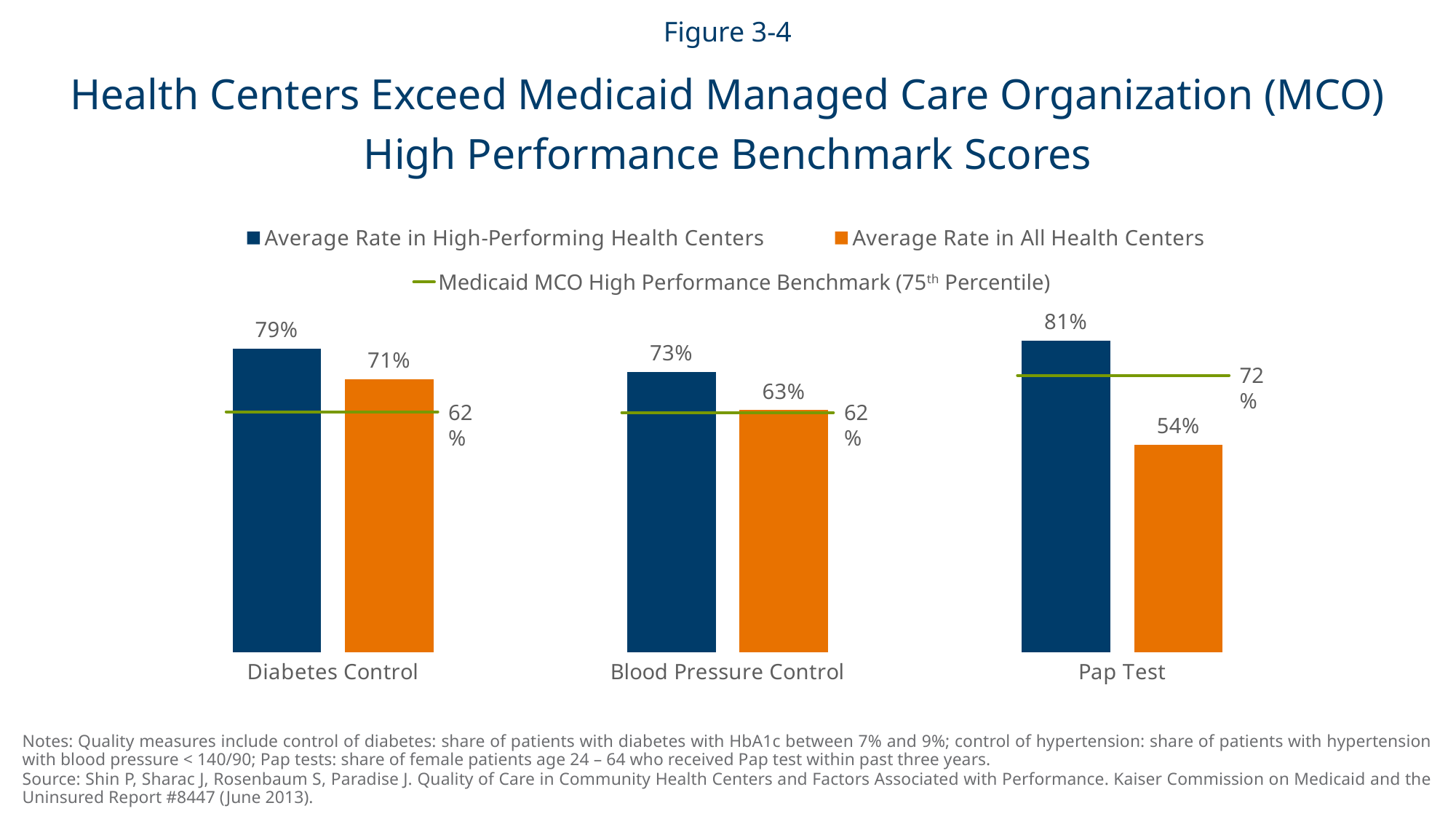
What is the Average Rate in All Health Centers for Blood Pressure Control? 63% How many categories are shown on the x axis? 3 What kind of chart is shown on the slide? Bar chart What is the difference between the Average Rate in All Health Centers for Diabetes Control and the Medicaid MCO High Performance Benchmark for Diabetes Control? 9% How many series does the legend list? 3 What is the Average Rate in All Health Centers for Pap Test? 54% What is the Average Rate in High-Performing Health Centers for Diabetes Control? 79% What is the Medicaid MCO High Performance Benchmark (75th Percentile) for Blood Pressure Control? 62% Which category has the lowest Average Rate in All Health Centers? Pap Test What is the difference between the Average Rate in High-Performing Health Centers and the Average Rate in All Health Centers for Pap Test? 27% Which is larger: the Average Rate in All Health Centers for Diabetes Control or for Blood Pressure Control? Diabetes Control Which category has the highest Average Rate in High-Performing Health Centers? Pap Test